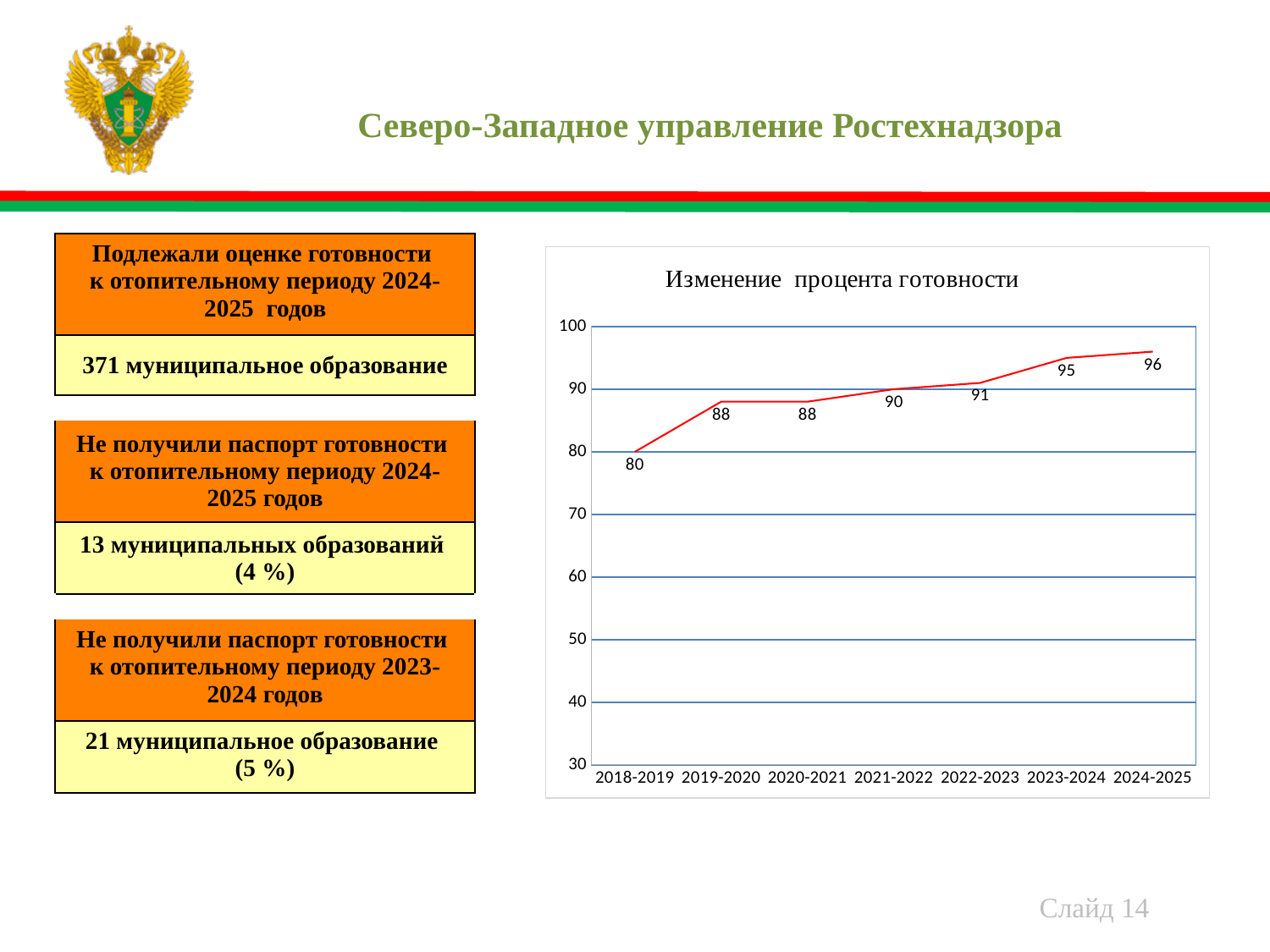
How many periods are shown on the x axis of the chart? 7 Is the value for 2020-2021 greater or less than 90? less What kind of chart is shown on the slide? line chart What is the value for 2024-2025 in the chart? 96 Do the values rise or fall from 2018-2019 to 2024-2025? rise Which period has the highest value in the chart? 2024-2025 What is the difference between the values for 2024-2025 and 2018-2019? 16 Which is larger, the value for 2019-2020 or the value for 2022-2023? 2022-2023 What is the difference between the values for 2023-2024 and 2022-2023? 4 What is the value for 2018-2019 in the chart? 80 Which period has the lowest value in the chart? 2018-2019 What is the value for 2021-2022 in the chart? 90